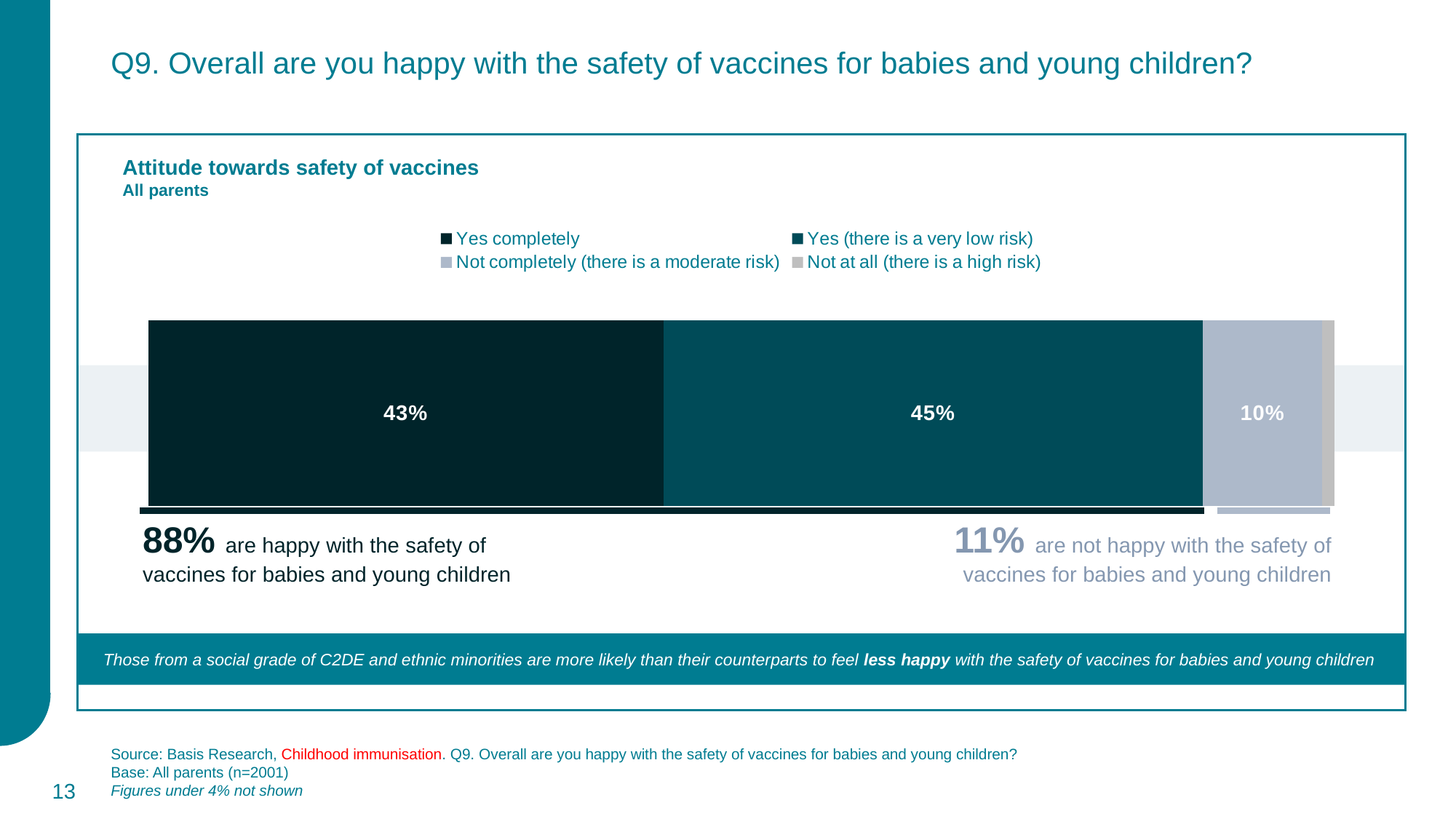
Which response has the largest share of the bar? Yes (there is a very low risk) What is the title of the chart? Attitude towards safety of vaccines What is the combined percentage of the two "Yes" segments ("Yes completely" and "Yes (there is a very low risk)")? 88% Which is larger: the share for "Yes completely" or for "Not completely (there is a moderate risk)"? Yes completely Which of the three labelled segments has the smallest value? Not completely (there is a moderate risk) Is the value for "Not at all (there is a high risk)" greater or less than 4%? less What kind of chart is shown on the slide? Stacked bar chart What percentage of parents answered "Yes (there is a very low risk)"? 45% How many response categories does the legend list? 4 What percentage of parents answered "Not completely (there is a moderate risk)"? 10% What percentage of parents answered "Yes completely"? 43% What is the difference in percentage points between "Yes (there is a very low risk)" and "Yes completely"? 2